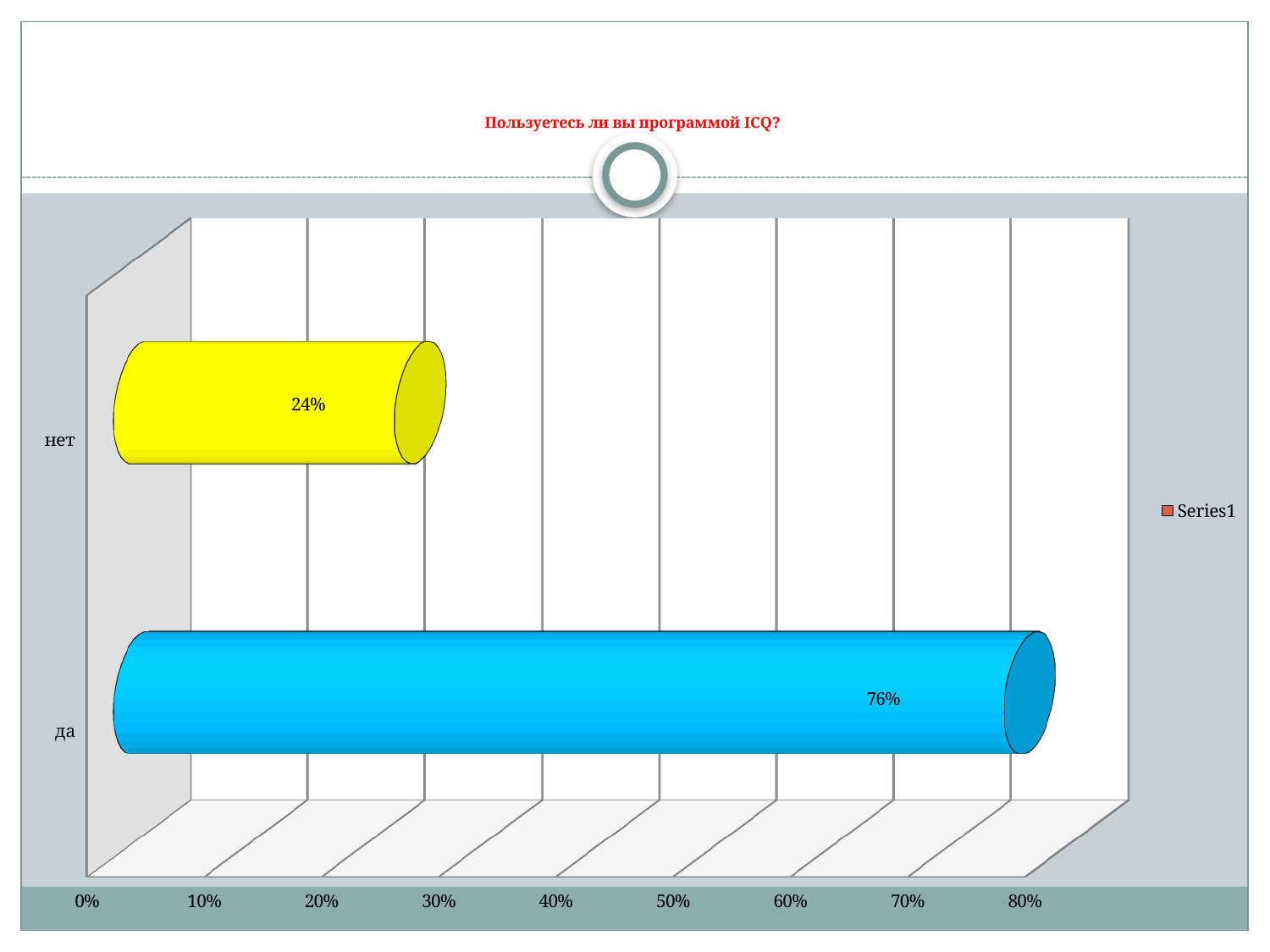
How many categories are shown in the chart? 2 What is the value for "нет"? 24% Which category has the lowest value? нет What is the difference between the values for "да" and "нет"? 52% What kind of chart is shown on the slide? bar chart How many series does the legend list? 1 Which is larger, the value for "да" or the value for "нет"? да Is the value for "нет" greater or less than 30%? less What is the value for "да"? 76% Is the value for "да" greater or less than 70%? greater Which category has the highest value? да What is the title of the chart? Пользуетесь ли вы программой ICQ?